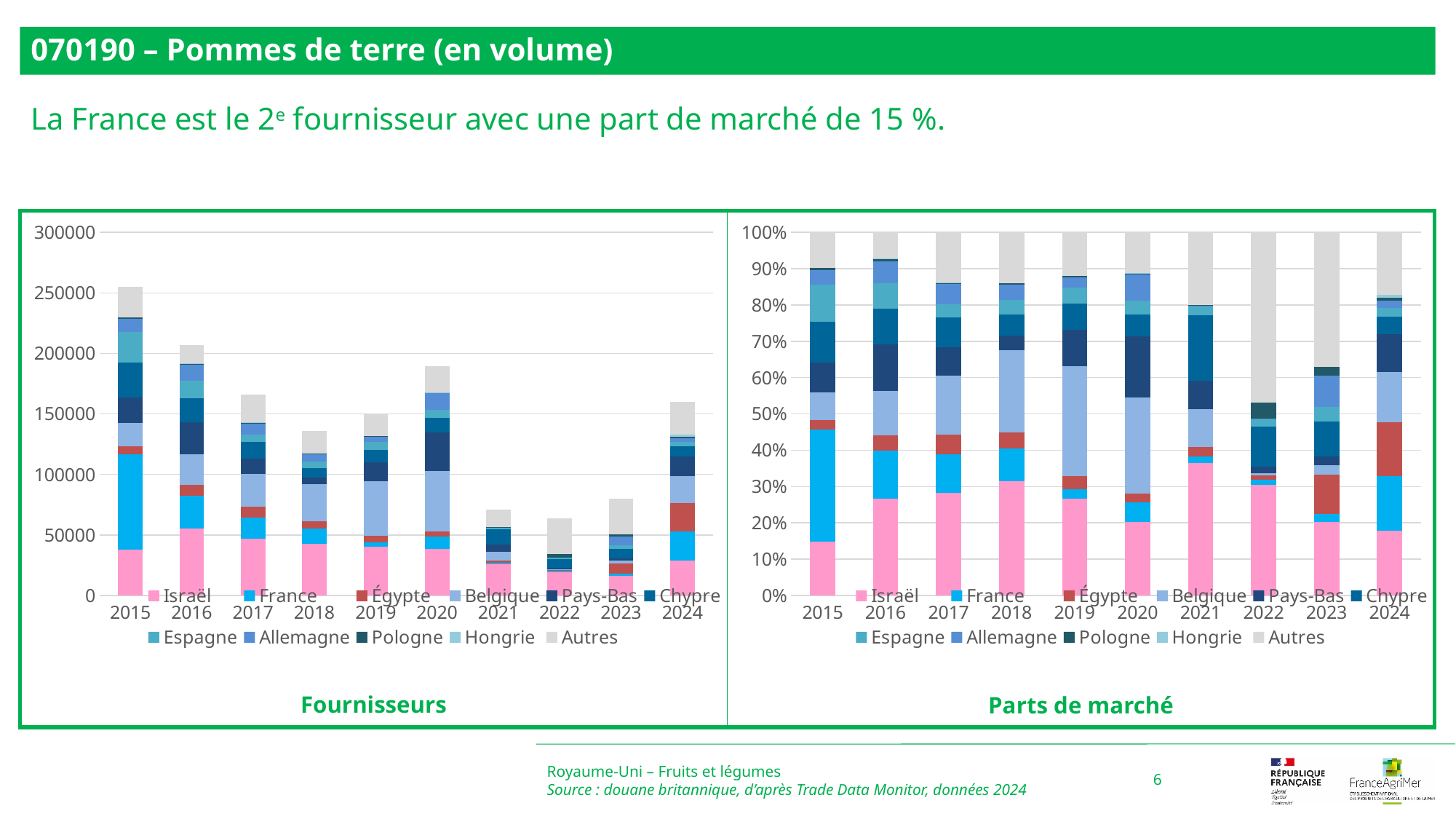
In the 'Parts de marché' chart, is the Israël share in 2021 greater or less than 30%? greater In the 'Fournisseurs' chart, which year has the larger total bar, 2019 or 2020? 2020 In the 'Fournisseurs' chart, is the total bar for 2015 greater or less than 250000? greater How many series does the legend of the 'Fournisseurs' chart list? 11 In the 'Fournisseurs' chart, do the total bars rise or fall from 2015 to 2018? fall How many years are shown on the x axis of the 'Parts de marché' chart? 10 In the 'Parts de marché' chart, is the Israël share in 2015 greater or less than 20%? less What kind of chart is the 'Fournisseurs' chart on the left? stacked bar chart In the 'Fournisseurs' chart, which year has the highest total bar? 2015 In the 'Fournisseurs' chart, which year has the lowest total bar? 2022